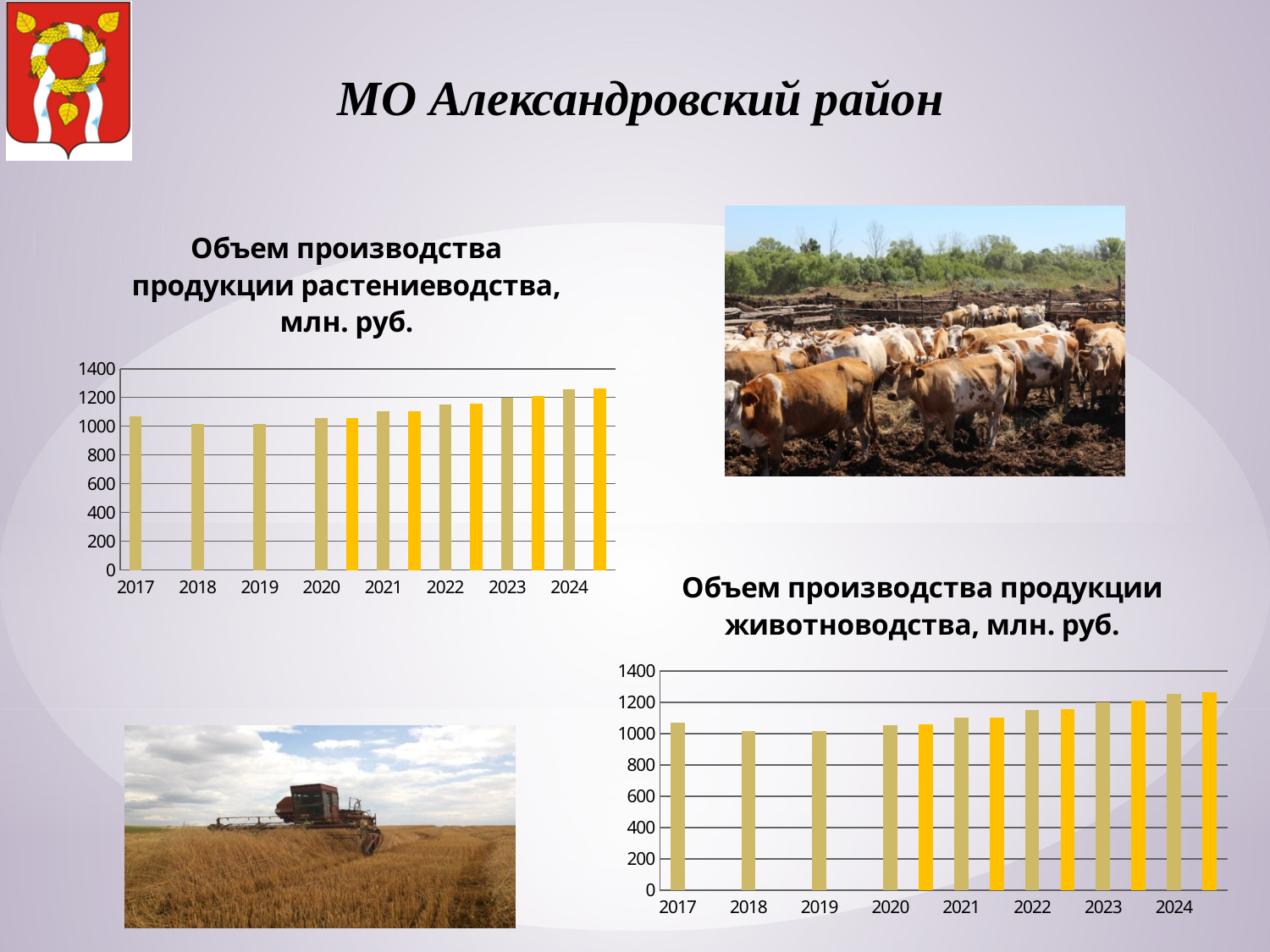
In the chart titled "Объем производства продукции животноводства, млн. руб.", which is larger, the value for 2018 or the value for 2024? 2024 In the chart titled "Объем производства продукции животноводства, млн. руб.", is the value for 2018 greater or less than 1200? less In the chart titled "Объем производства продукции животноводства, млн. руб.", how many years are shown on the x axis? 8 In the chart titled "Объем производства продукции растениеводства, млн. руб.", how many years are shown on the x axis? 8 What kind of chart is the chart titled "Объем производства продукции животноводства, млн. руб."? bar chart In the chart titled "Объем производства продукции животноводства, млн. руб.", do the values generally rise or fall from 2019 to 2024? rise What is the first year shown on the x axis of the chart titled "Объем производства продукции растениеводства, млн. руб."? 2017 In the chart titled "Объем производства продукции растениеводства, млн. руб.", is the value for 2017 greater or less than 1000? greater In the chart titled "Объем производства продукции животноводства, млн. руб.", is the value for 2023 greater or less than 1400? less In the chart titled "Объем производства продукции растениеводства, млн. руб.", which year has the highest value? 2024 What kind of chart is the chart titled "Объем производства продукции растениеводства, млн. руб."? bar chart